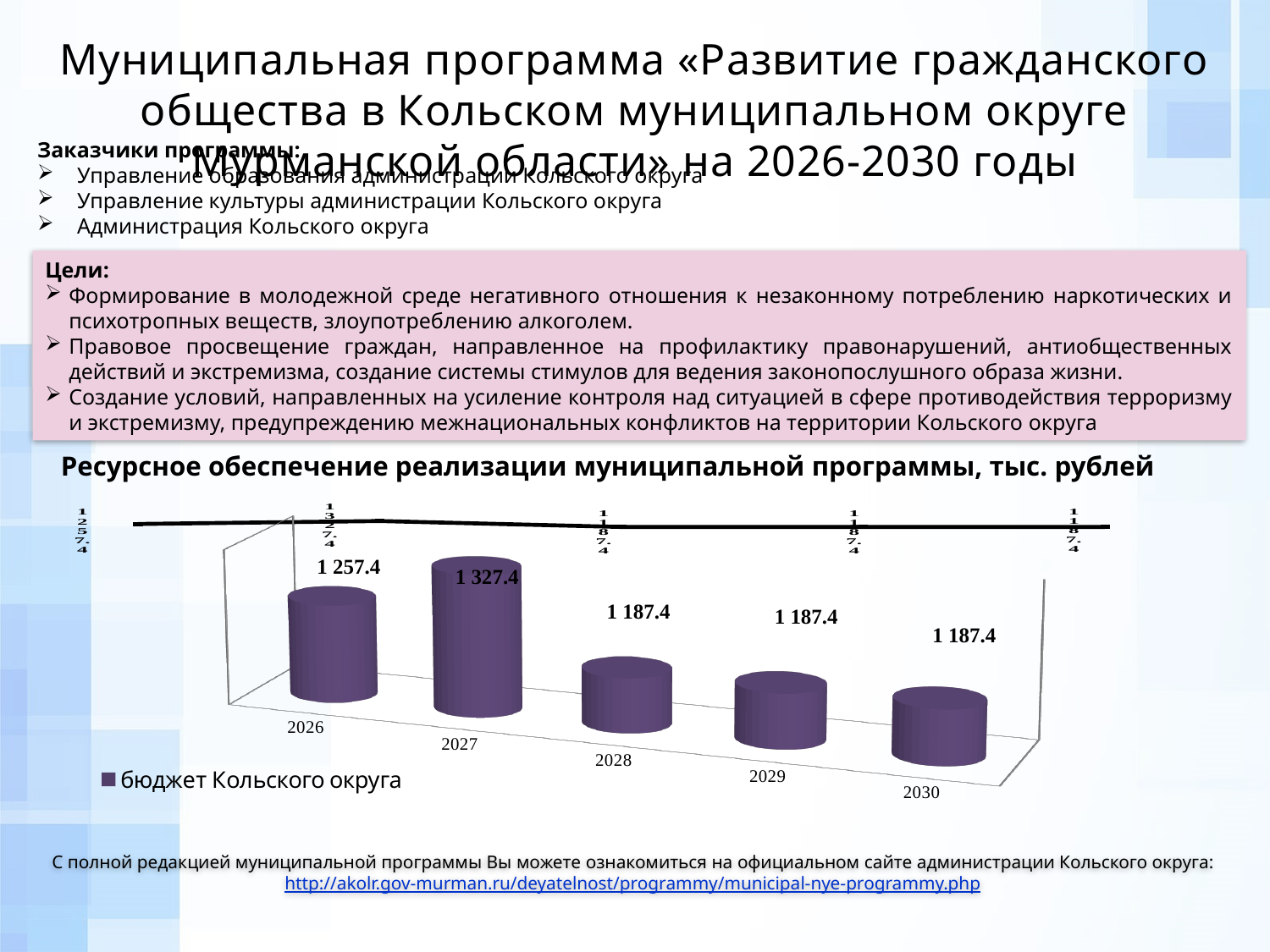
Do the values rise or fall from 2027 to 2028? fall What is the value for 2026 in the chart? 1 257.4 Which is larger, the value for 2026 or the value for 2029? 2026 What is the difference between the values for 2026 and 2028? 70.0 How many years are shown on the x axis of the chart? 5 Which year has the highest value in the chart? 2027 How many series does the chart legend list? 1 What is the value for 2027 in the chart? 1 327.4 What is the legend entry of the chart? бюджет Кольского округа What is the difference between the values for 2027 and 2026? 70.0 What kind of chart is shown on the slide? bar chart What is the value for 2030 in the chart? 1 187.4